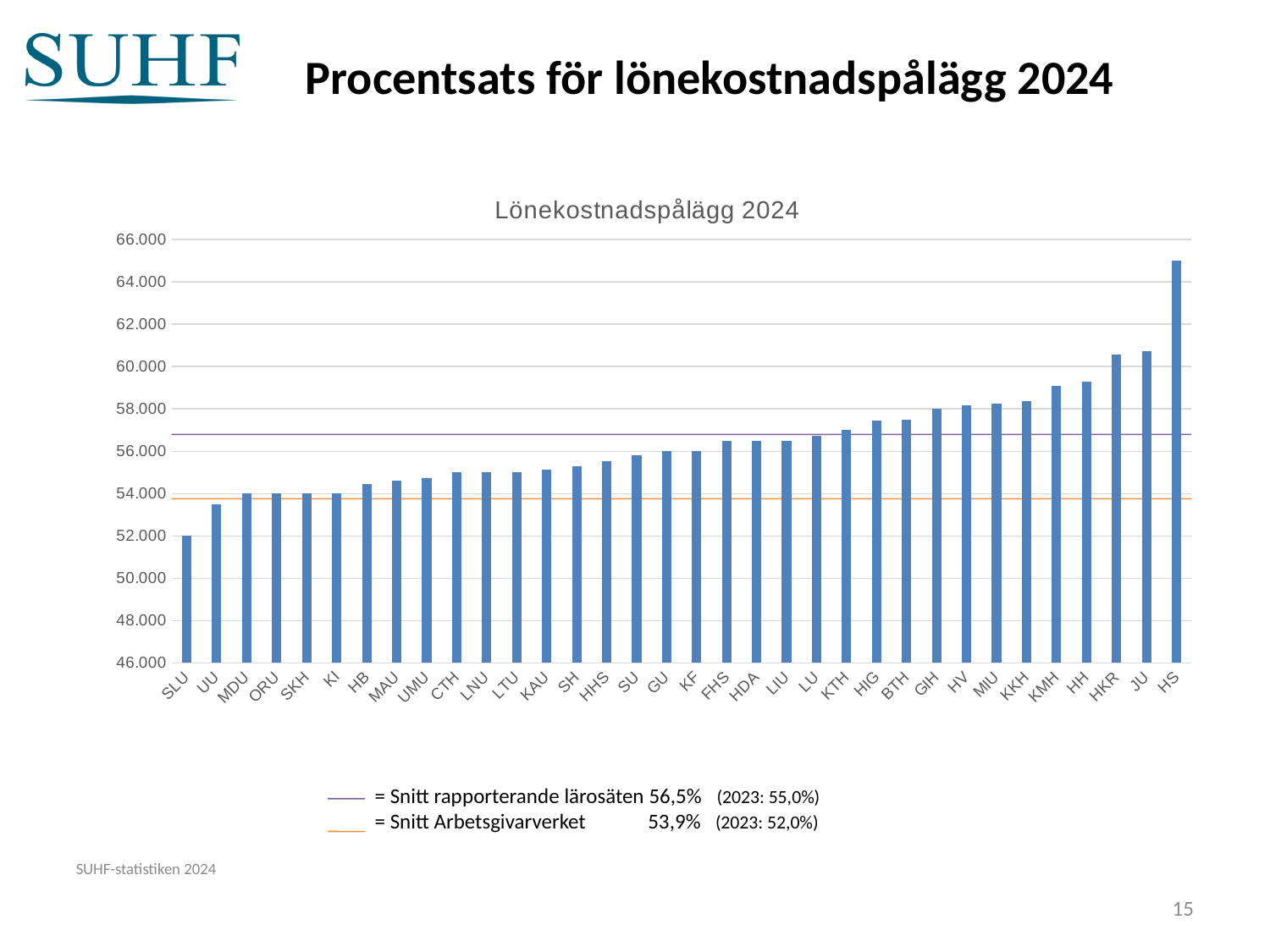
What is the title of the chart? Lönekostnadspålägg 2024 Which has the larger value, HS or SLU? HS According to the legend below the chart, what is the value of 'Snitt rapporterande lärosäten' for 2024? 56,5% Is the value for KTH greater or less than 56.000? greater Which category has the lowest value in the chart? SLU Which category has the highest value in the chart? HS Is the value for HS greater or less than 64.000? greater Do the bar values rise or fall from left to right along the x axis? rise Is the value for KMH greater or less than 60.000? less How many categories are plotted along the x axis? 34 What kind of chart is shown on the slide? bar chart